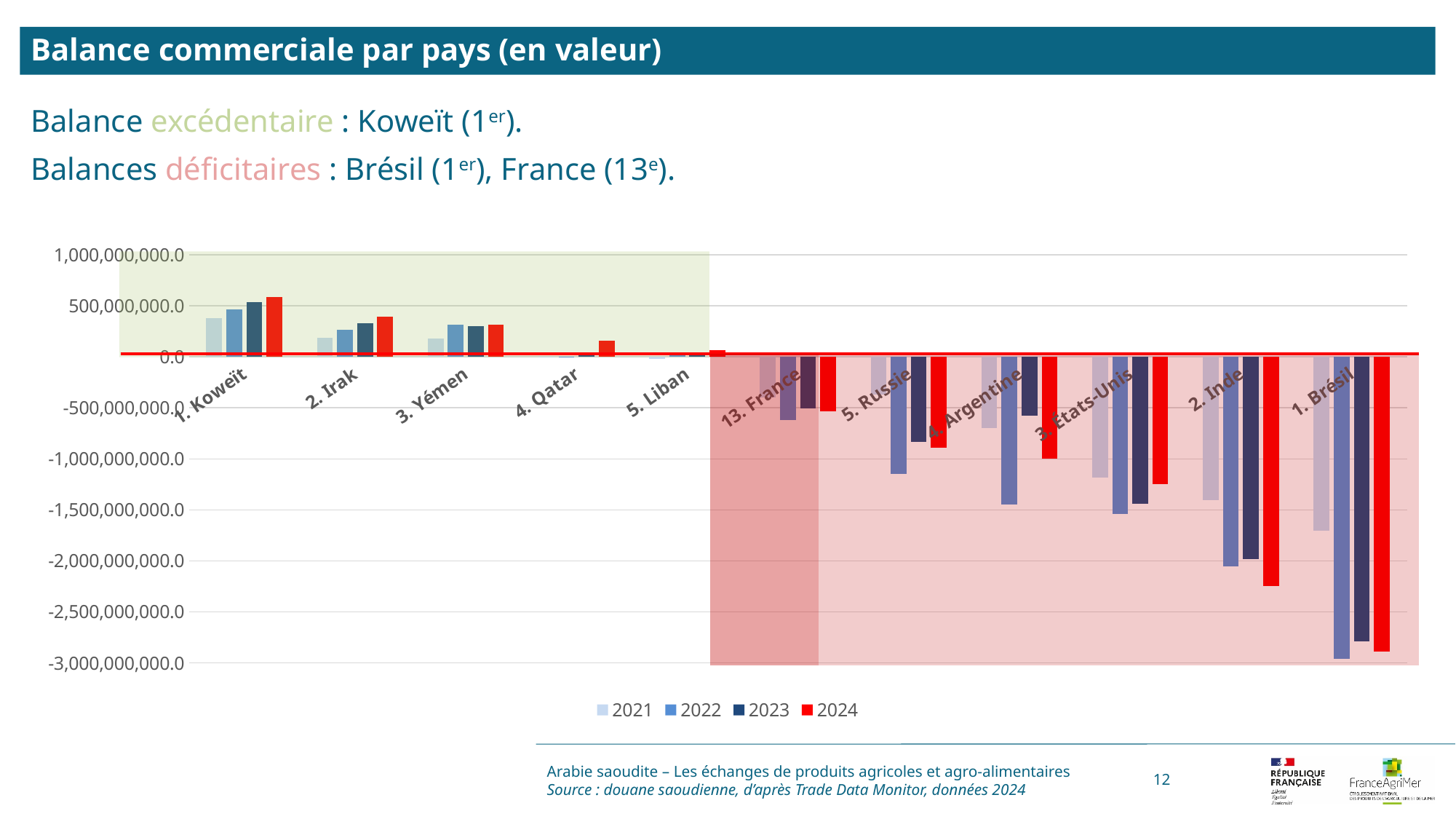
Which series in the legend is shown in red? 2024 How many series does the chart legend list? 4 How many countries (categories) are shown on the x axis of the chart? 11 Is the 2024 value for 1. Koweït greater or less than 500,000,000.0? greater Is the 2024 value for 2. Inde greater or less than -2,000,000,000.0? less Which country has the lowest 2024 value in the chart? 1. Brésil Is the 2024 value for 1. Brésil greater or less than -2,500,000,000.0? less Which country has the highest 2024 value in the chart? 1. Koweït What kind of chart is shown on the slide? bar chart Do the values for 1. Koweït rise or fall from 2021 to 2024? rise Which is larger, the 2024 value for 1. Koweït or the 2024 value for 2. Irak? 1. Koweït